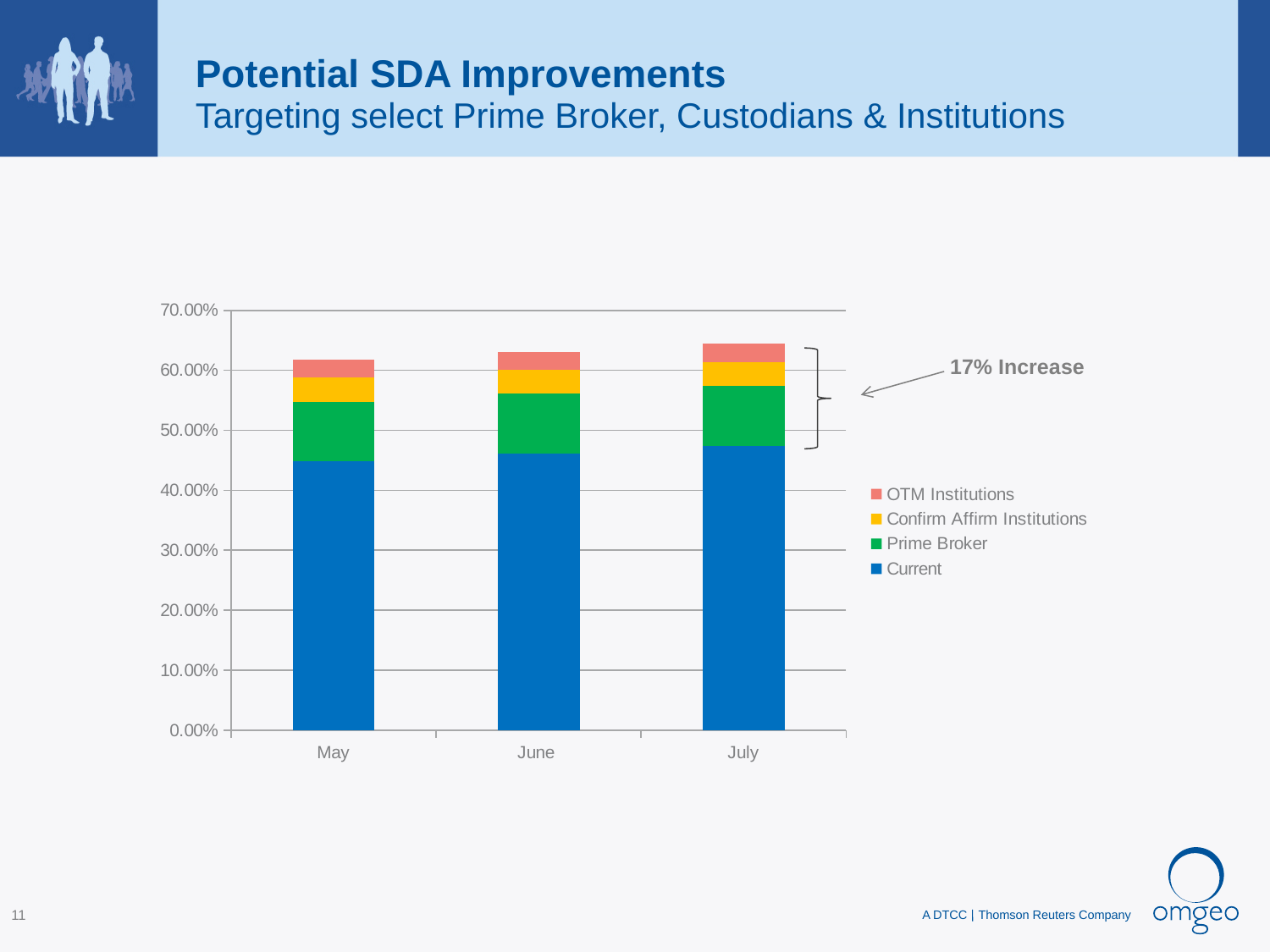
Is the total height of the stacked bar for May greater or less than 70.00%? less Is the value of the Current series for July greater or less than 50.00%? less Which colour represents the Prime Broker series in the chart? Green Is the total height of the stacked bar for July greater or less than 60.00%? greater How many series does the chart's legend list? 4 What does the annotation next to the bracket on the right of the July bar say? 17% Increase Which month has the taller stacked bar overall, May or July? July How many months are shown on the x axis of the chart? 3 Which month has the tallest stacked bar overall? July Does the Current series rise or fall from May to July? rise What kind of chart is shown on the slide? Stacked bar chart